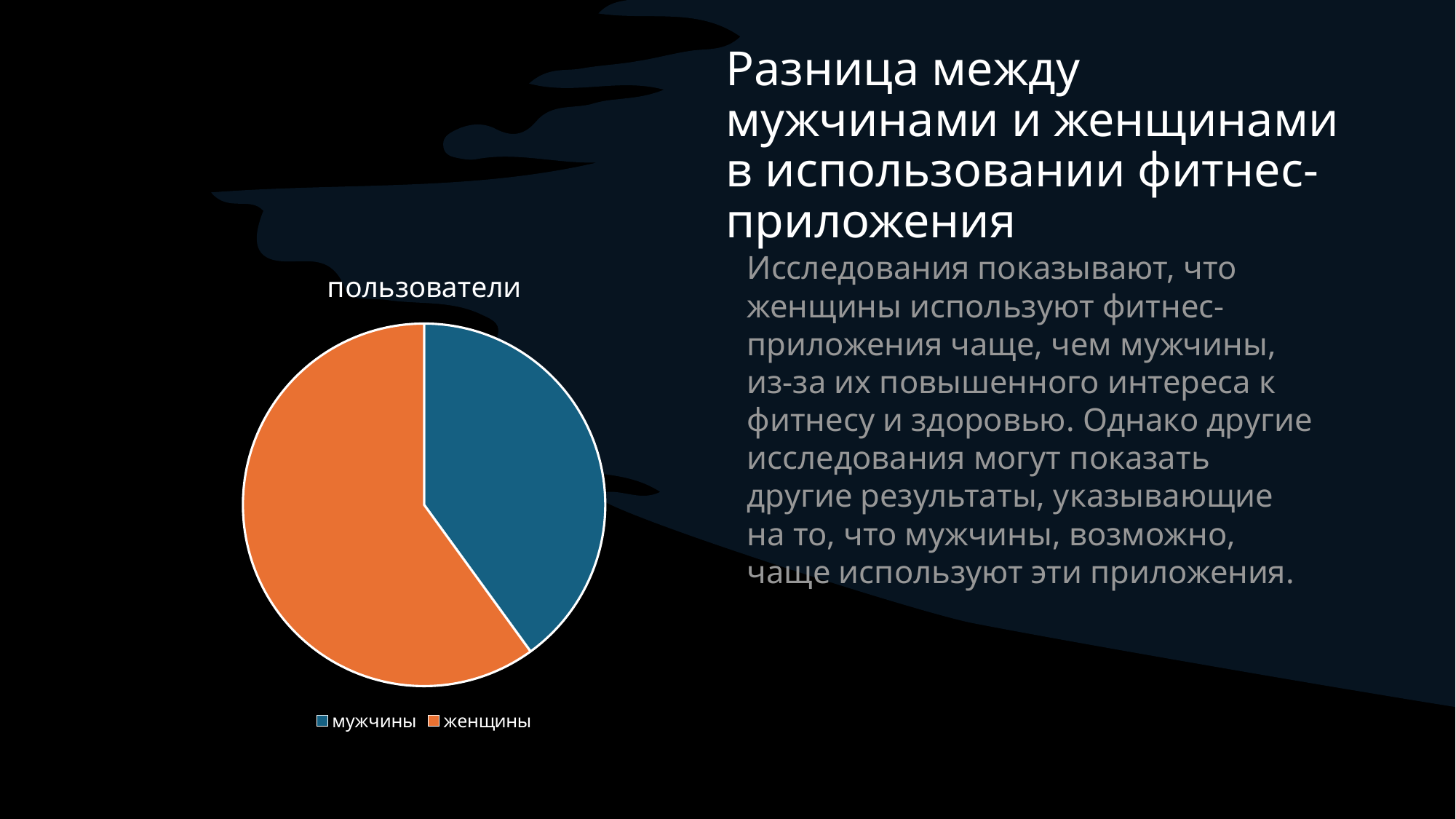
Which category has the smallest slice in the pie chart? мужчины What is the title of the pie chart? пользователи How many slices does the pie chart have? 2 What kind of chart is shown on the slide? pie chart Which slice is larger in the pie chart, мужчины or женщины? женщины How many entries does the legend of the pie chart list? 2 What colour is the slice for мужчины in the pie chart? blue Which category has the largest slice in the pie chart? женщины